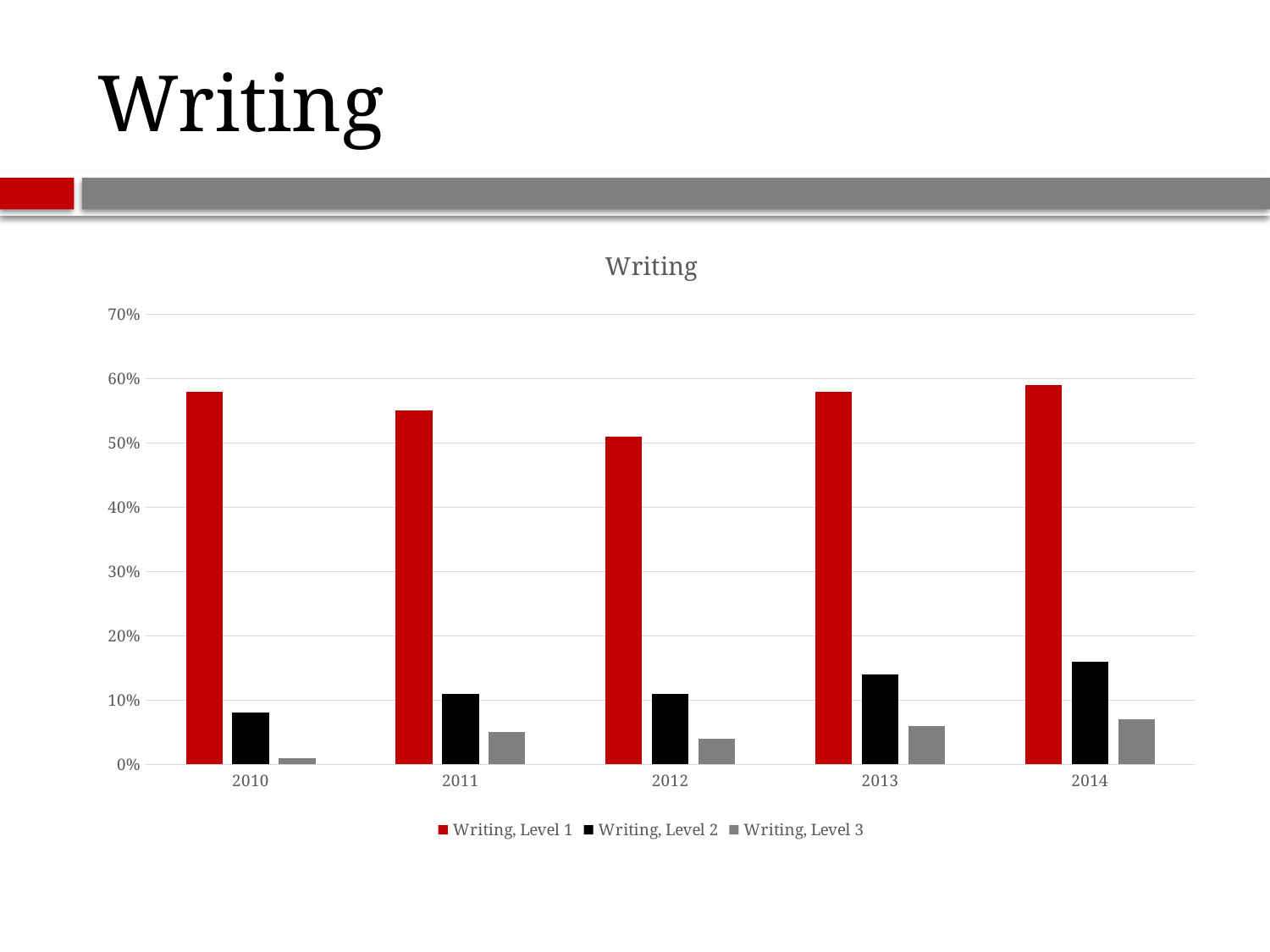
How many years are shown on the x axis? 5 What is the title of the chart? Writing How many series does the legend list? 3 Does the Writing, Level 2 value generally rise or fall from 2010 to 2014? Rise What type of chart is shown on the slide? Bar chart In which year is the Writing, Level 1 value lowest? 2012 In which year is the Writing, Level 3 value lowest? 2010 Which is larger in 2013: Writing, Level 2 or Writing, Level 3? Writing, Level 2 Is the value for Writing, Level 2 in 2014 greater or less than 10%? greater In which year is the Writing, Level 2 value highest? 2014 Which series is shown in red? Writing, Level 1 Is the value for Writing, Level 1 in 2010 greater or less than 50%? greater